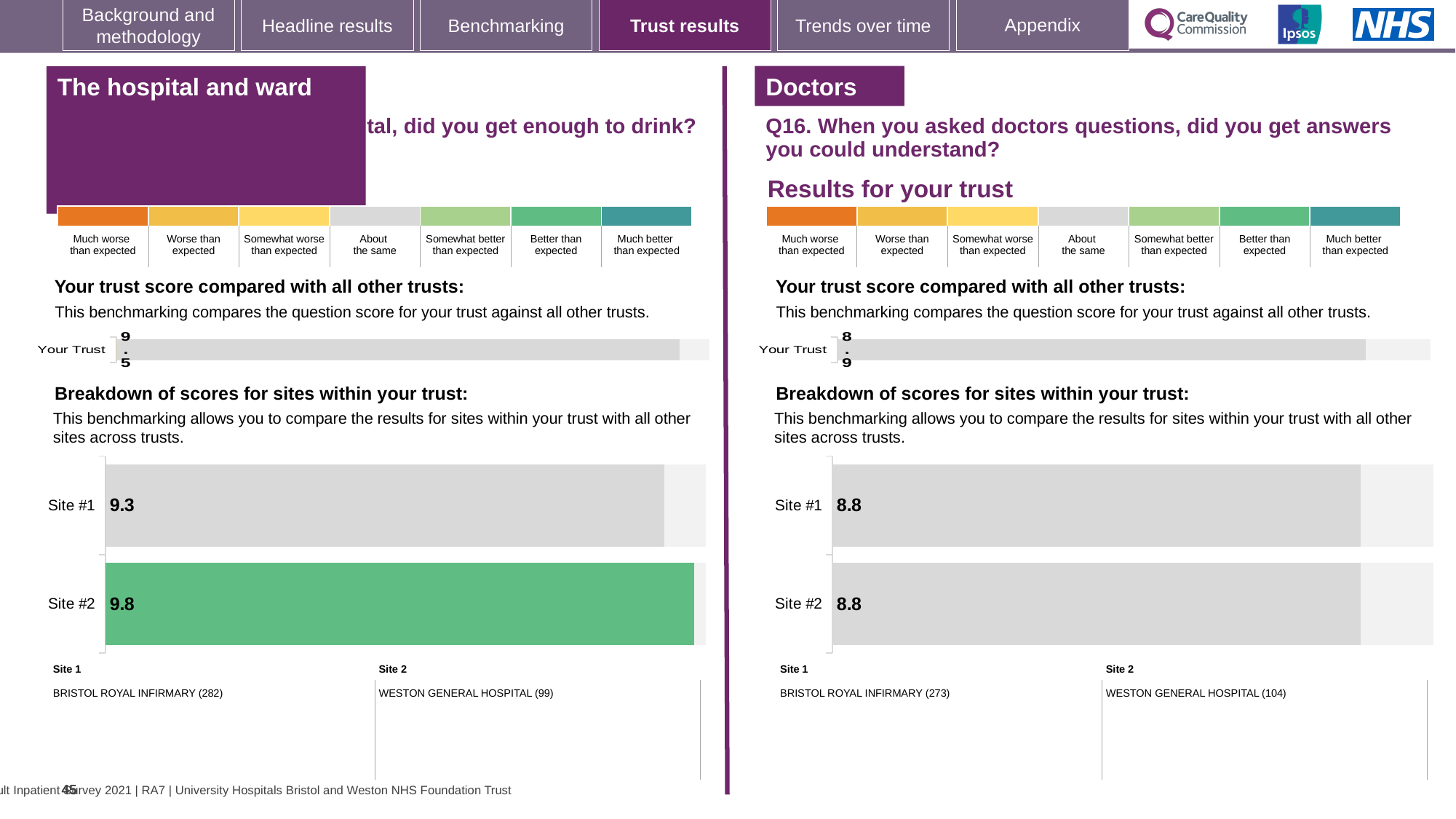
On the left-hand chart (did you get enough to drink?), which site has the higher score? Site #2 What kind of chart is used for the breakdown of scores for sites on the left-hand side of the slide? Bar chart On the left-hand chart (did you get enough to drink?), what is the score for Site #2? 9.8 On the right-hand chart (Q16, doctors), what is the score for Site #1? 8.8 On the right-hand chart (Q16, doctors), how many sites are shown in the breakdown of scores? 2 On the left-hand chart (did you get enough to drink?), what is the difference between the Site #2 and Site #1 scores? 0.5 On the right-hand chart (Q16, doctors), what is the score for Site #2? 8.8 On the right-hand chart (Q16, doctors), what is the 'Your Trust' score? 8.9 On the left-hand chart (did you get enough to drink?), which site's bar is coloured green? Site #2 On the right-hand chart (Q16, doctors), which hospital is Site 2? WESTON GENERAL HOSPITAL (104) On the left-hand chart (did you get enough to drink?), what is the 'Your Trust' score? 9.5 On the left-hand chart (did you get enough to drink?), what is the score for Site #1? 9.3